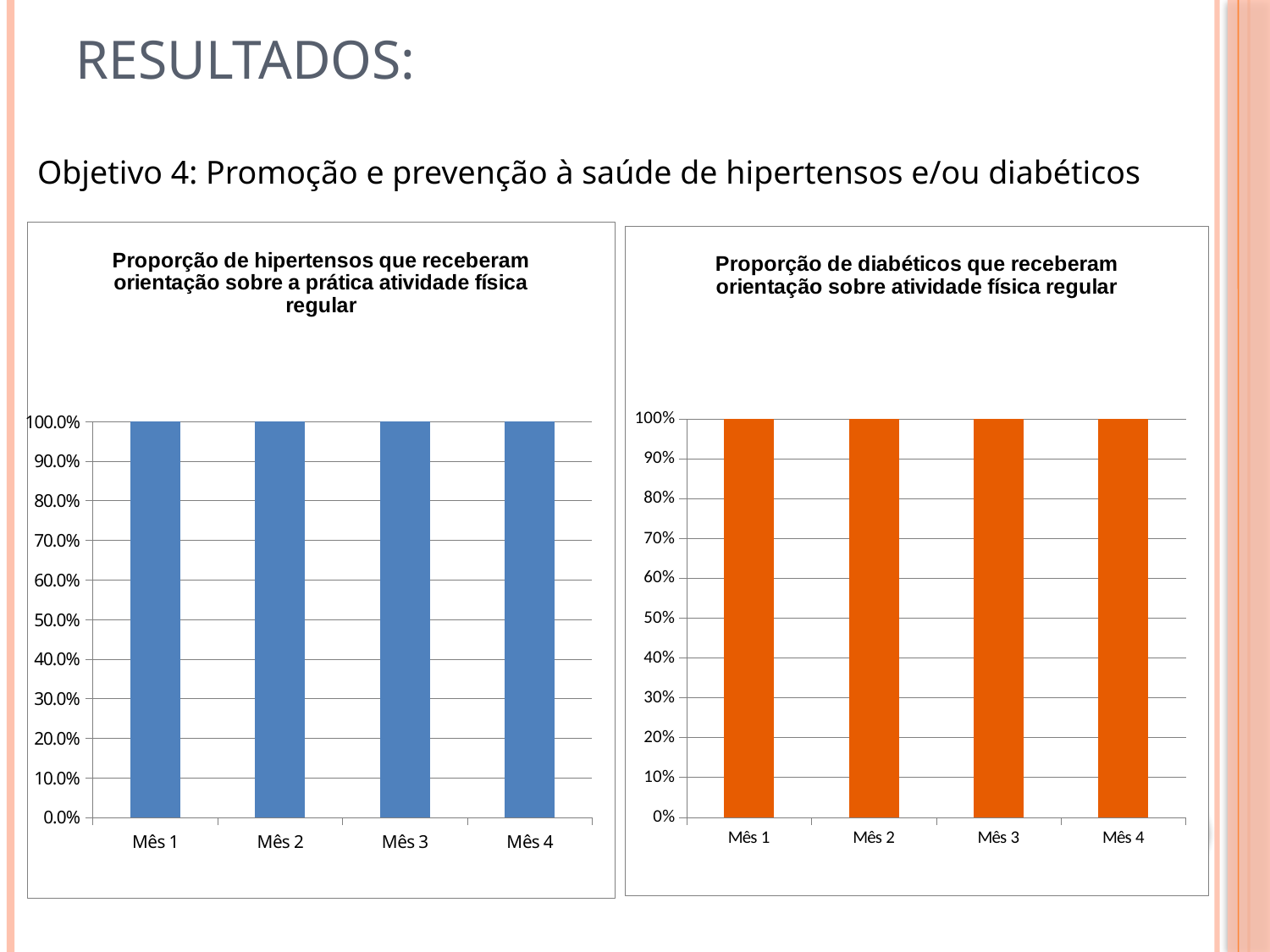
How many bars are plotted in the right chart (Proporção de diabéticos)? 4 In the right chart (Proporção de diabéticos que receberam orientação sobre atividade física regular), what is the value for Mês 3? 100% In the left chart (Proporção de hipertensos), what is the difference between the values for Mês 1 and Mês 4? 0.0% What kind of chart is the right chart (Proporção de diabéticos)? Bar chart In the right chart (Proporção de diabéticos), do the values rise, fall or stay the same from Mês 1 to Mês 4? Stay the same What colour are the bars in the right chart (Proporção de diabéticos)? Orange What kind of chart is the left chart (Proporção de hipertensos)? Bar chart In the right chart (Proporção de diabéticos), is the value for Mês 4 greater or less than 50%? greater In the left chart (Proporção de hipertensos que receberam orientação sobre a prática atividade física regular), what is the value for Mês 1? 100.0% How many categories are shown on the x axis of the left chart (Proporção de hipertensos)? 4 In the left chart (Proporção de hipertensos), what is the value for Mês 4? 100.0% In the right chart (Proporção de diabéticos), what is the value for Mês 2? 100%